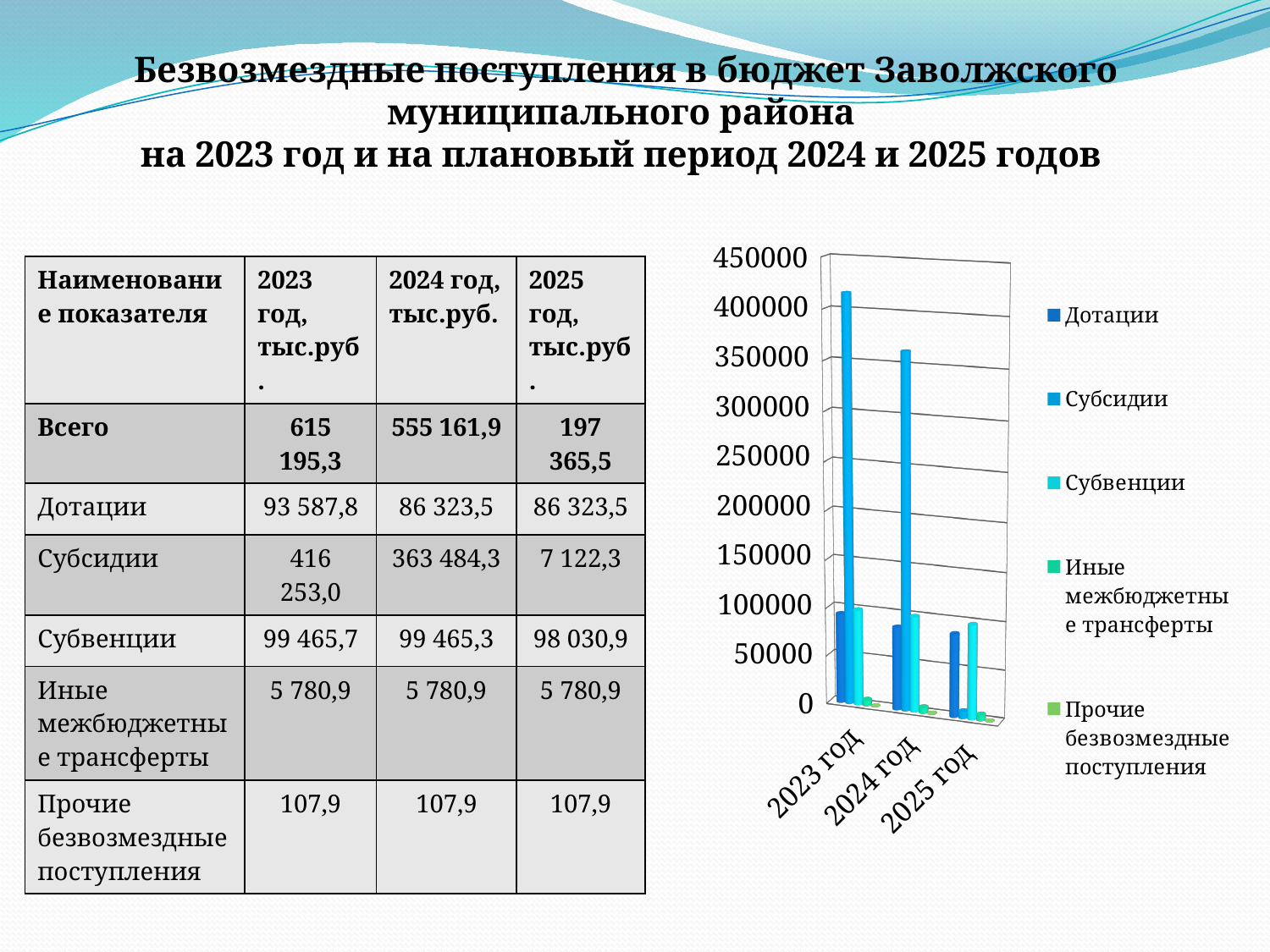
What is the highest value shown on the chart's vertical axis? 450000 Which year has the shortest Субсидии bar in the chart? 2025 год Which year has the tallest Субсидии bar in the chart? 2023 год Is the Субсидии bar for 2023 год greater or less than 400000? greater According to the slide, what is the value of Субсидии for 2024 год? 363 484,3 In 2024 год, which is larger in the chart: Субсидии or Дотации? Субсидии Do the Субсидии values rise or fall from 2023 год to 2025 год? fall How many year categories are shown on the x axis of the chart? 3 What kind of chart is shown on the slide? bar chart How many series does the chart legend list? 5 Is the Дотации bar for 2023 год greater or less than 150000? less Is the Субсидии bar for 2025 год greater or less than 50000? less